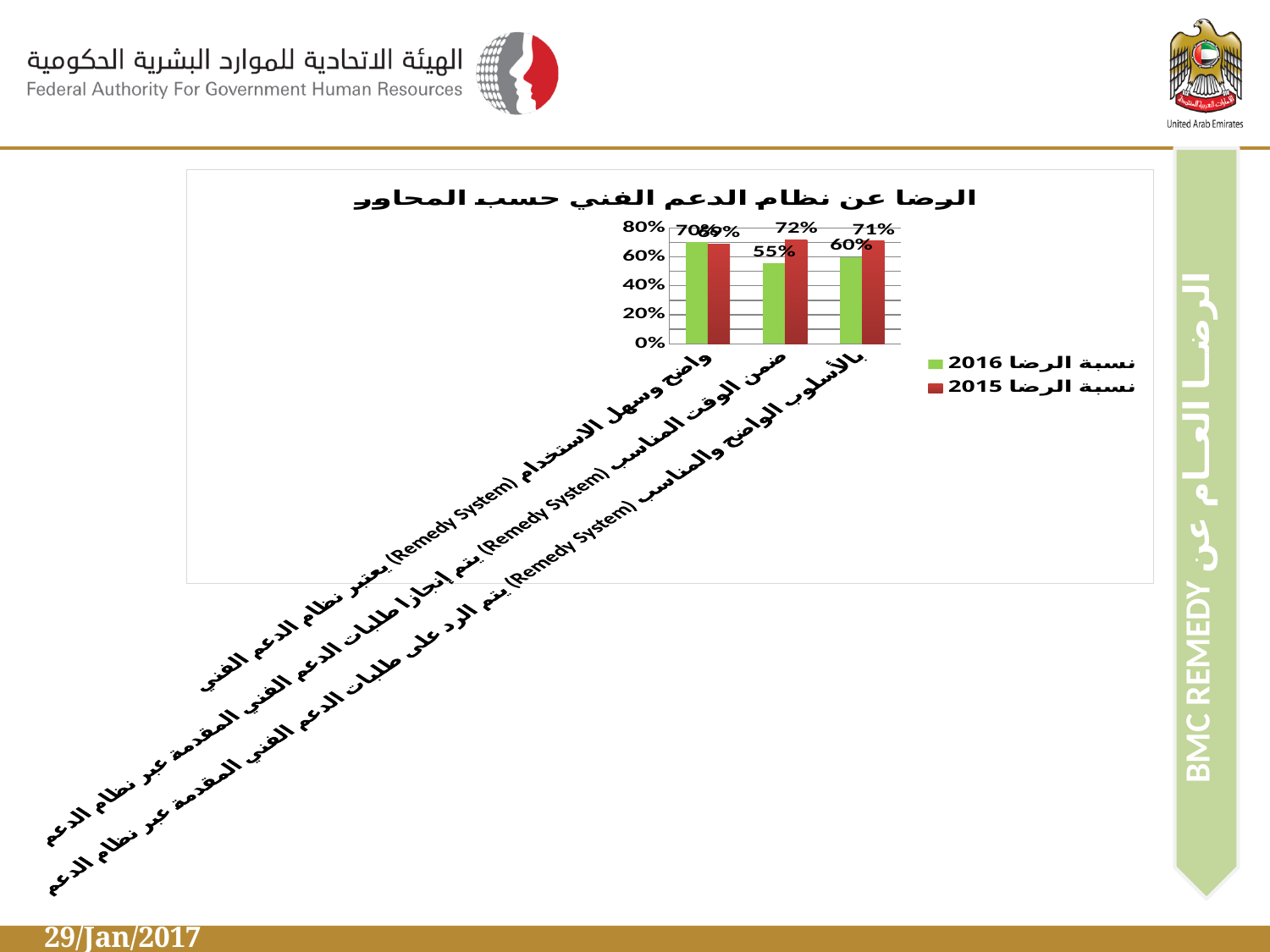
What is the 2016 satisfaction rate for the third category, about requests being answered in a clear and appropriate manner (بالأسلوب الواضح والمناسب)? 60% What is the 2016 satisfaction rate for the first category, about the system being clear and easy to use (واضح وسهل الاستخدام)? 70% What colour represents the 2016 satisfaction series (نسبة الرضا 2016) in the legend? green Which category has the lowest 2016 satisfaction rate? the second category (ضمن الوقت المناسب) How many categories are plotted along the x axis? 3 What is the 2015 satisfaction rate (نسبة الرضا 2015) for the second category, about requests being completed within the appropriate time (ضمن الوقت المناسب)? 72% What is the 2016 satisfaction rate (نسبة الرضا 2016) for the second category, about requests being completed within the appropriate time (ضمن الوقت المناسب)? 55% For the second category (ضمن الوقت المناسب), what is the difference between the 2015 and 2016 satisfaction rates? 17 percentage points What kind of chart is shown on the slide? bar chart What is the 2015 satisfaction rate for the third category, about requests being answered in a clear and appropriate manner (بالأسلوب الواضح والمناسب)? 71% For the third category (بالأسلوب الواضح والمناسب), which year has the higher satisfaction rate, 2015 or 2016? 2015 How many series does the legend list? 2